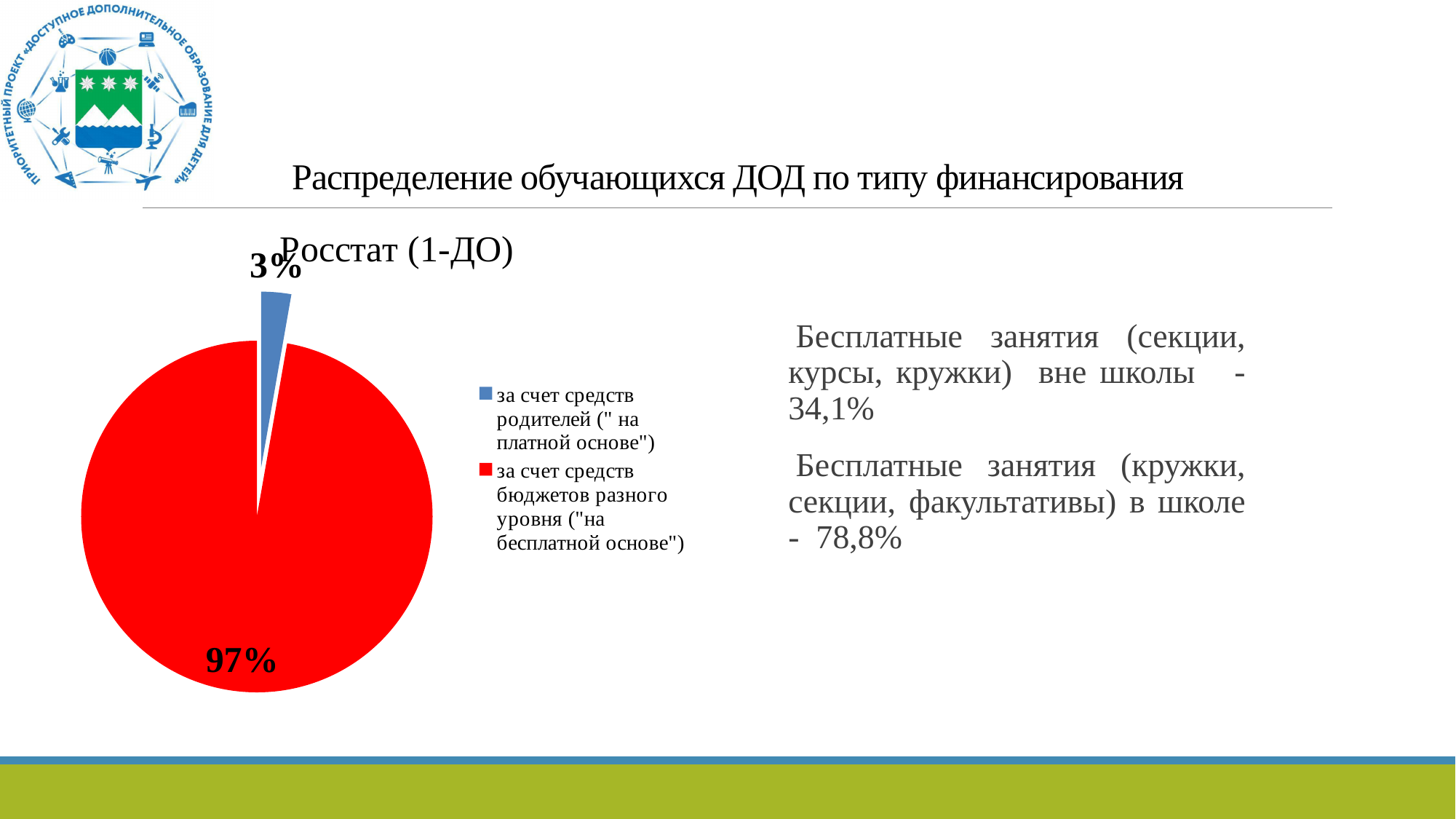
Which is larger: the slice for funding from parents or the slice for funding from budgets of different levels? за счет средств бюджетов разного уровня ("на бесплатной основе") What kind of chart is shown on the slide? pie chart What share of the pie is labelled for "за счет средств родителей (" на платной основе")"? 3% What is the difference in percentage points between the 97% slice and the 3% slice? 94 How many entries does the legend list? 2 Which category has the largest slice of the pie? за счет средств бюджетов разного уровня ("на бесплатной основе") What share of the pie is labelled for "за счет средств бюджетов разного уровня ("на бесплатной основе")"? 97% How many slices does the pie chart have? 2 What is the title of the pie chart? Росстат (1-ДО) Which category has the smallest slice of the pie? за счет средств родителей (" на платной основе") What colour is the slice for "за счет средств бюджетов разного уровня ("на бесплатной основе")"? red